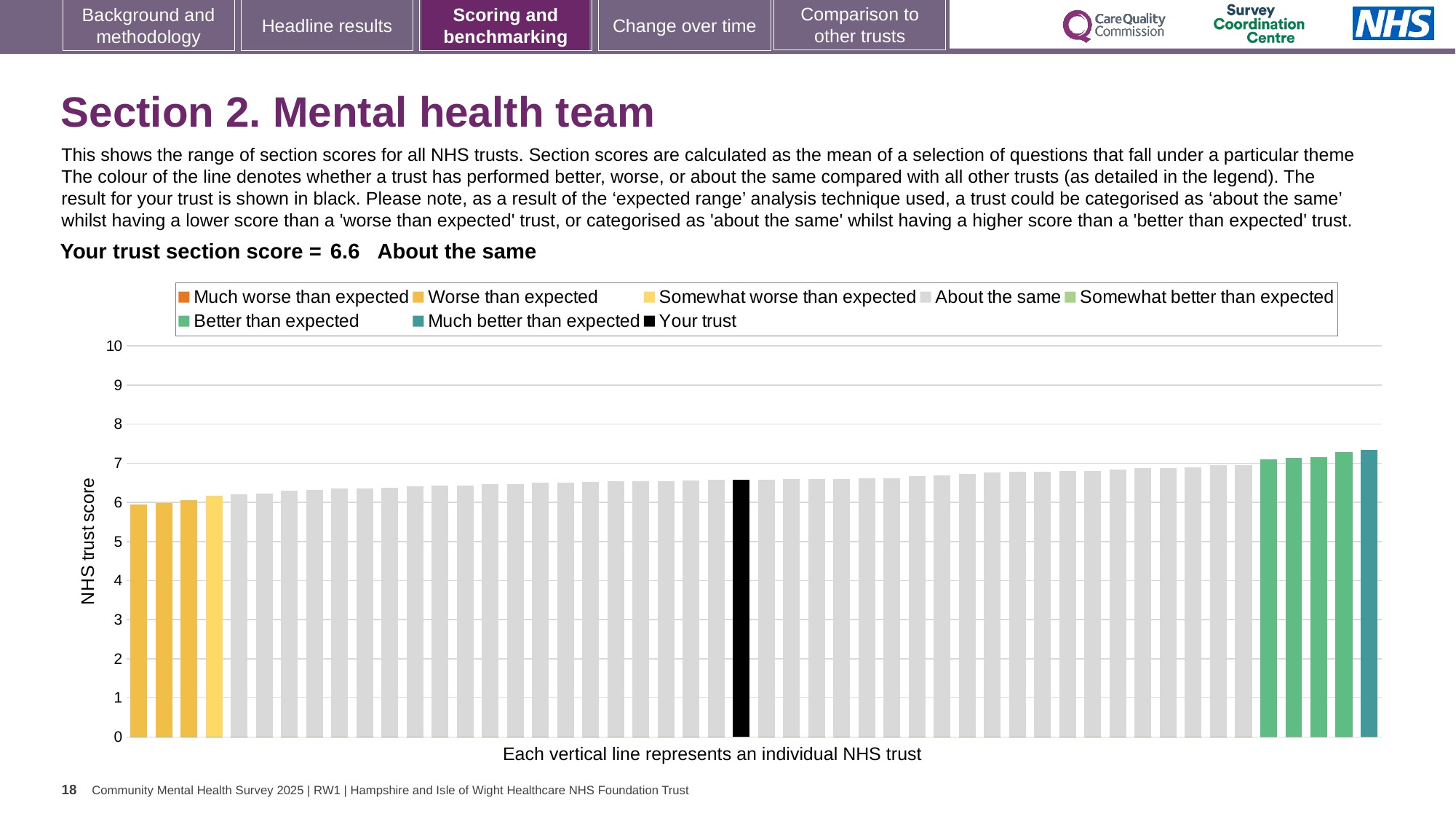
What colour is the bar representing your trust? black What is the label on the vertical axis of the chart? NHS trust score What kind of chart is shown on the slide? bar chart Do the bar values rise or fall from left to right along the x axis? rise How many entries does the chart legend list? 8 How many bars are coloured black to represent your trust? 1 Is the value for your trust greater or less than 7? less What is the section score for your trust shown on the slide? 6.6 Is the value for your trust greater or less than 6? greater Which category is your trust's section score placed in? About the same Is the value of the highest bar greater or less than 7? greater